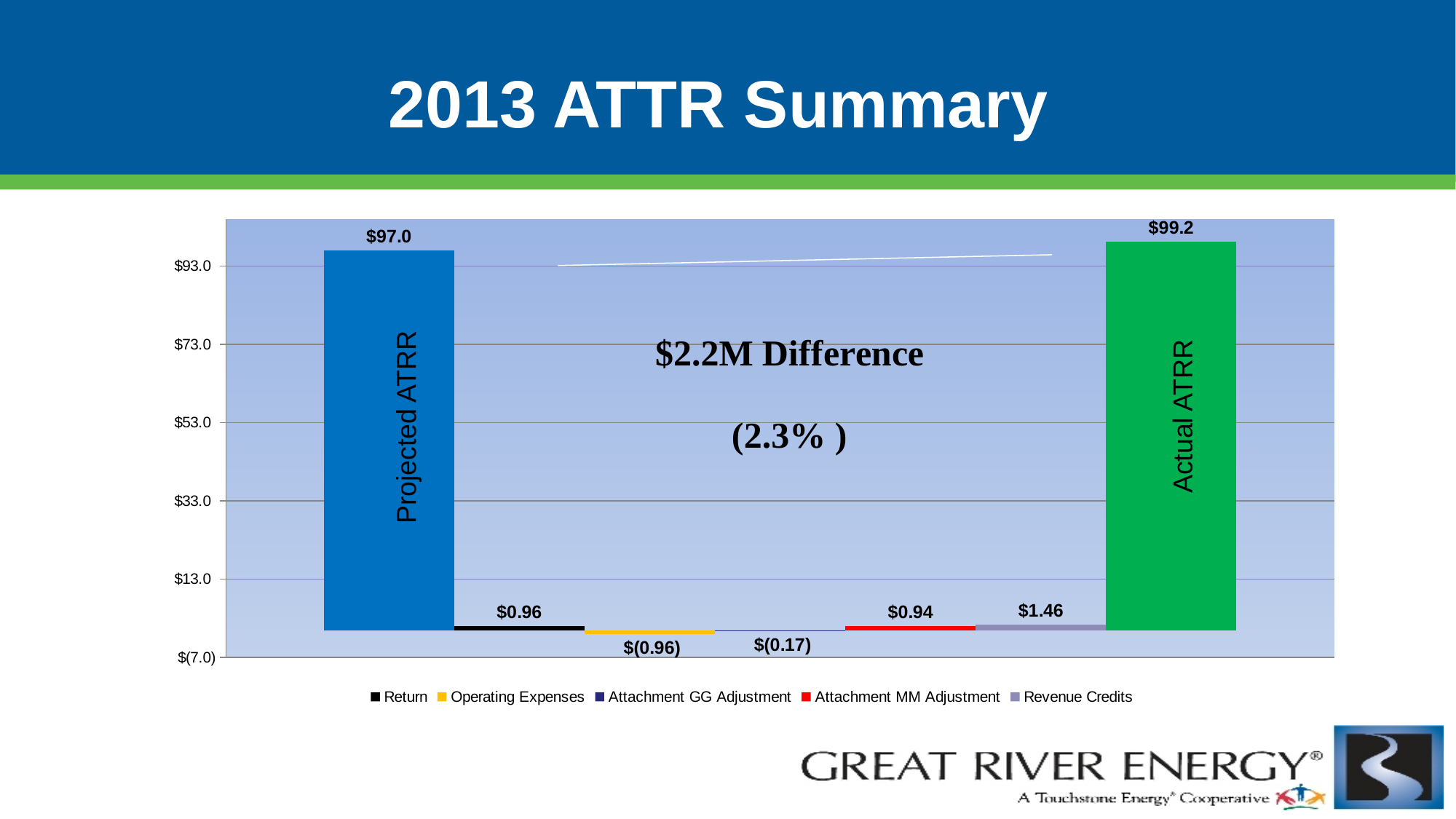
Which is larger, Projected ATRR or Actual ATRR? Actual ATRR What is the data label on the Attachment GG Adjustment bar? $(0.17) What percentage difference is annotated in the middle of the chart? 2.3% What is the value shown for Projected ATRR? $97.0 What is the value shown for Actual ATRR? $99.2 How many series does the legend list? 5 What is the data label on the Operating Expenses bar? $(0.96) Is the value for Projected ATRR greater or less than $93.0? greater What is the difference between Actual ATRR ($99.2) and Projected ATRR ($97.0)? $2.2 What is the data label on the Return bar? $0.96 What is the data label on the Revenue Credits bar? $1.46 What kind of chart is shown on the slide? Bar chart